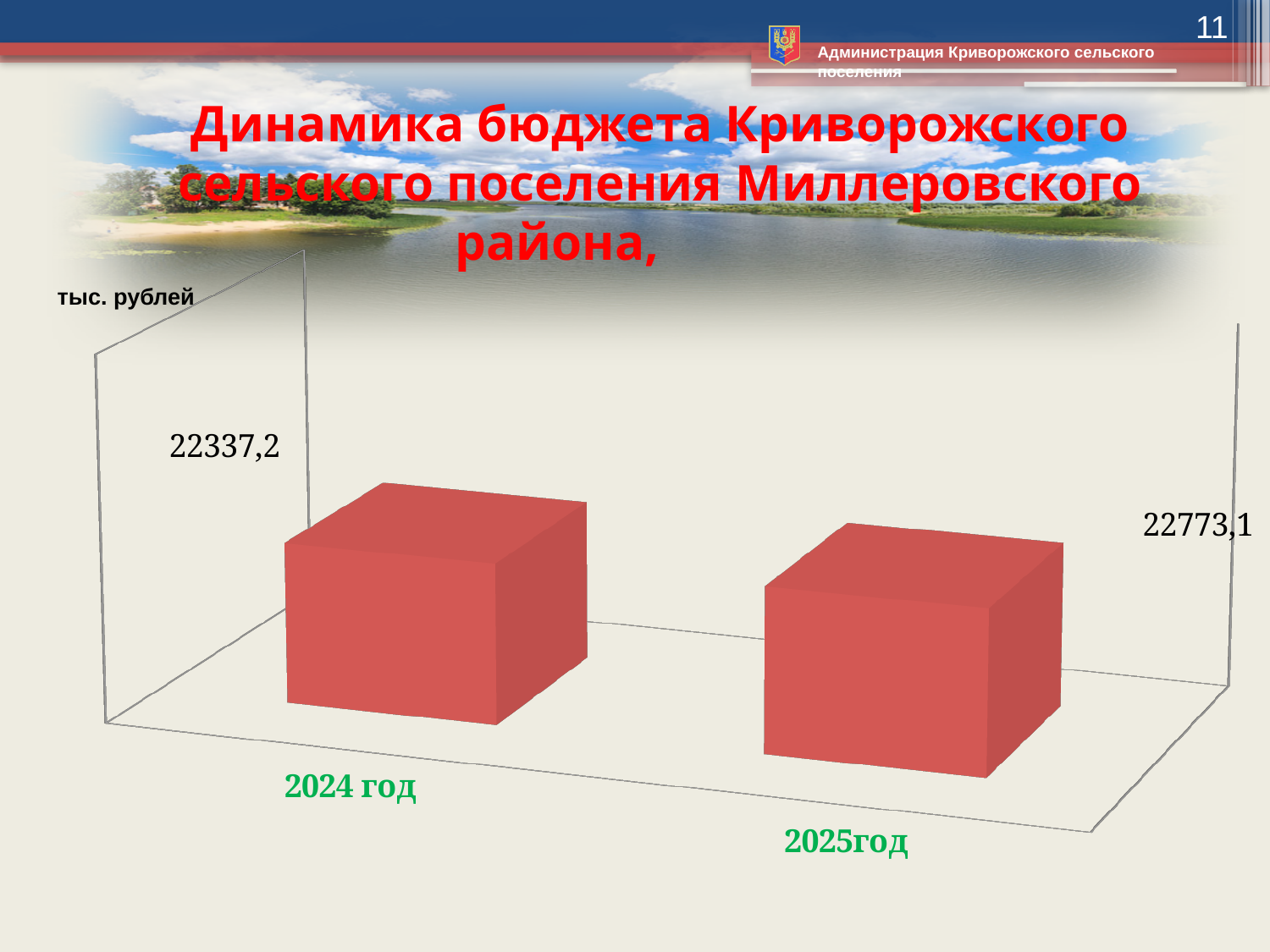
Which year has the lower budget value? 2024 год What kind of chart is shown on the slide? bar chart What colour are the bars in the chart? red Does the budget value rise or fall from 2024 to 2025? rise How many years (categories) are shown in the chart? 2 Is the value for 2025год larger or smaller than the value for 2024 год? larger What is the difference between the 2025 and 2024 budget values? 435,9 Which year has the higher budget value? 2025год In what units are the chart values given? тыс. рублей What is the budget value shown for 2024 год? 22337,2 What is the budget value shown for 2025год? 22773,1